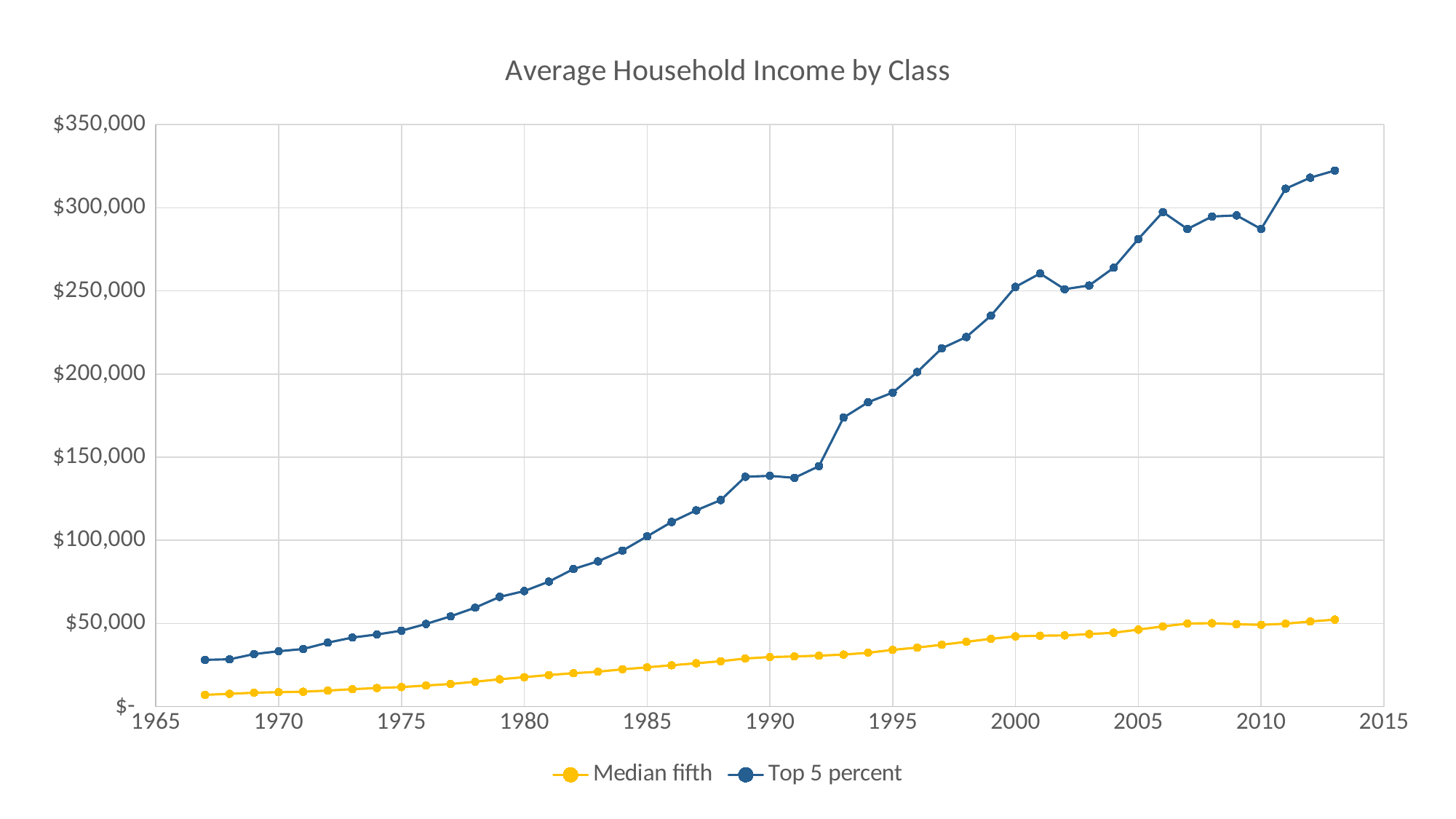
Is the value for Top 5 percent in 1990 greater or less than $150,000? less What is the title of the chart? Average Household Income by Class Does the Median fifth series generally rise or fall from 1967 to 2013? rise Which series has the higher value in 2010, Median fifth or Top 5 percent? Top 5 percent What kind of chart is shown on the slide? line chart Which series is drawn in blue? Top 5 percent Is the value for Median fifth in 2000 greater or less than $50,000? less Is the value for Top 5 percent in 1980 greater or less than $100,000? less How many series does the legend list? 2 For the Top 5 percent series, which year has the higher value, 2010 or 2011? 2011